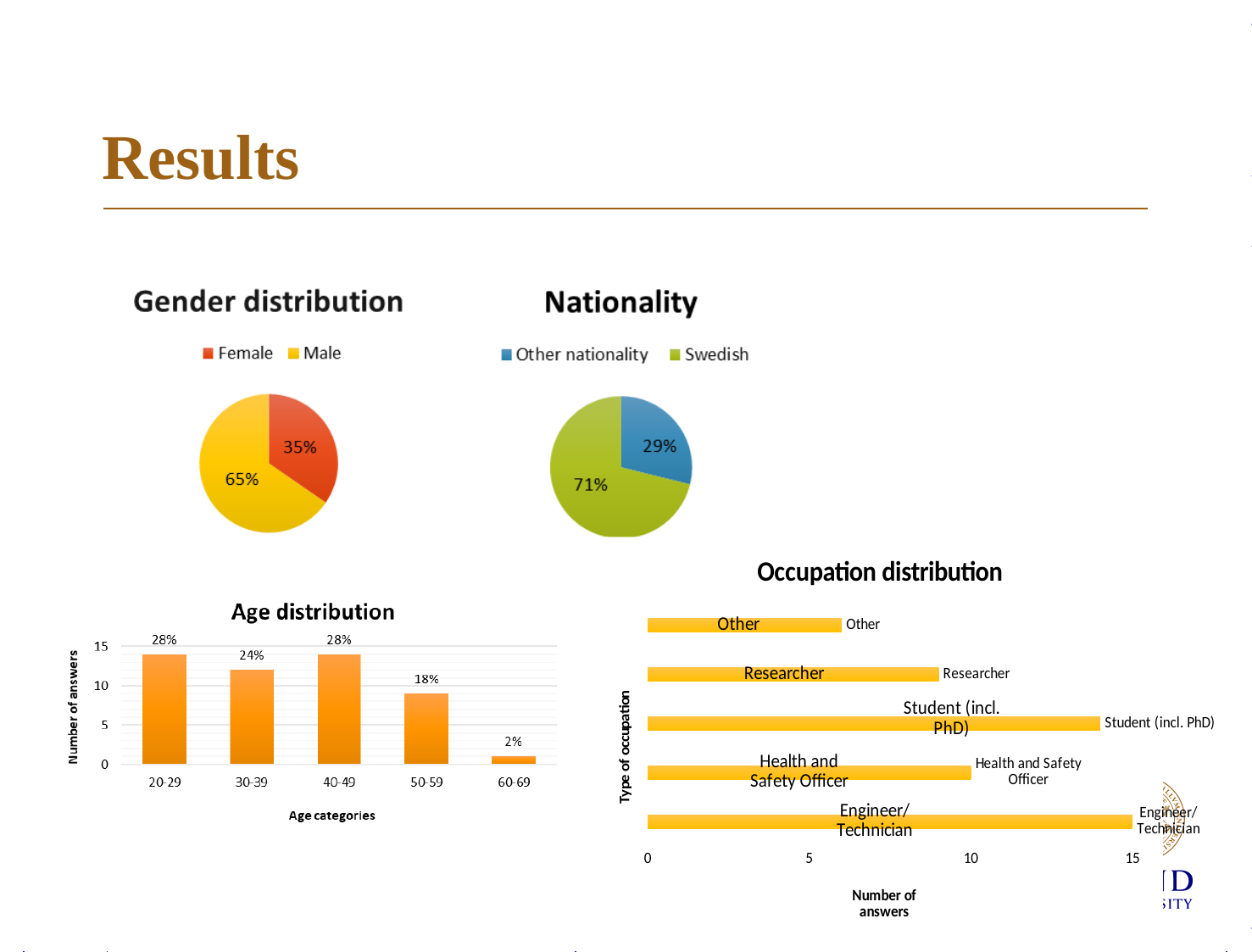
In the Age distribution chart, which is larger, the value for 50-59 or the value for 30-39? 30-39 How many age categories are shown in the Age distribution chart? 5 In the Nationality chart, what is the difference in percentage points between Swedish and Other nationality? 42 In the Age distribution chart, what percentage is shown for the 30-39 age category? 24% What kind of chart is the Nationality chart? Pie chart How many series does the legend of the Gender distribution chart list? 2 In the Gender distribution chart, what percentage is Male? 65% In the Age distribution chart, which age category has the lowest value? 60-69 In the Nationality chart, what share of the pie is Swedish? 71% In the Gender distribution chart, what percentage is Female? 35% In the Occupation distribution chart, is the number of answers for Other greater or less than 10? less In the Occupation distribution chart, which occupation has the highest number of answers? Engineer/Technician